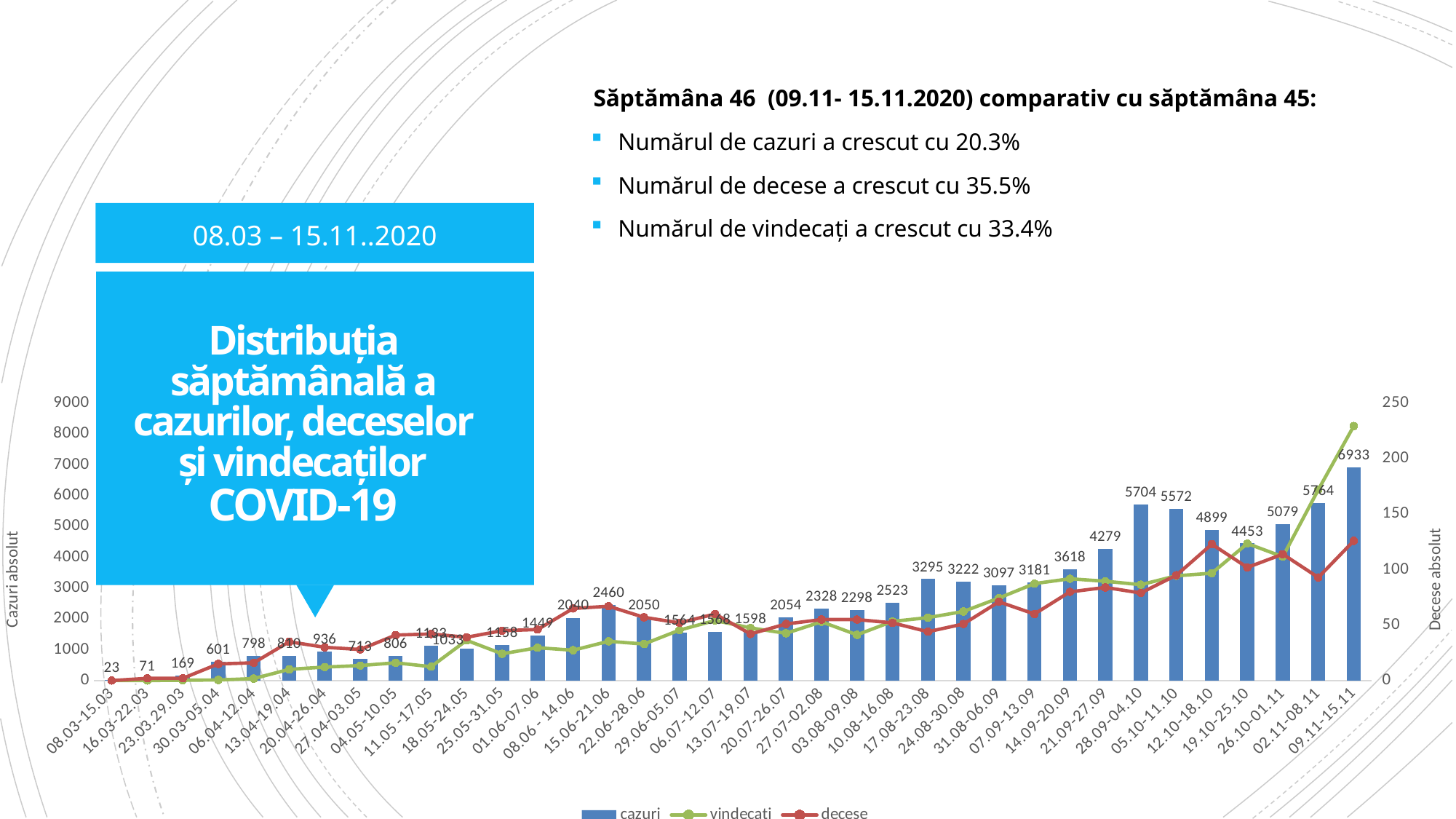
Is the value of vindecati for the week 09.11-15.11 greater or less than 200 on the right axis? greater What is the value of cazuri for the week 09.11-15.11? 6933 How many series does the legend list? 3 Which week has the lowest number of cazuri? 08.03-15.03 Which week has more cazuri, 28.09-04.10 or 05.10-11.10? 28.09-04.10 What is the value of cazuri for the week 28.09-04.10? 5704 What are the three series named in the legend? cazuri, vindecati, decese Which week has the highest number of cazuri? 09.11-15.11 What kind of chart is shown on the slide? Combination bar and line chart Is the value of decese for the week 09.11-15.11 greater or less than 100 on the right axis? greater What is the value of cazuri for the week 15.06-21.06? 2460 What is the difference in cazuri between the weeks 09.11-15.11 and 02.11-08.11? 1169